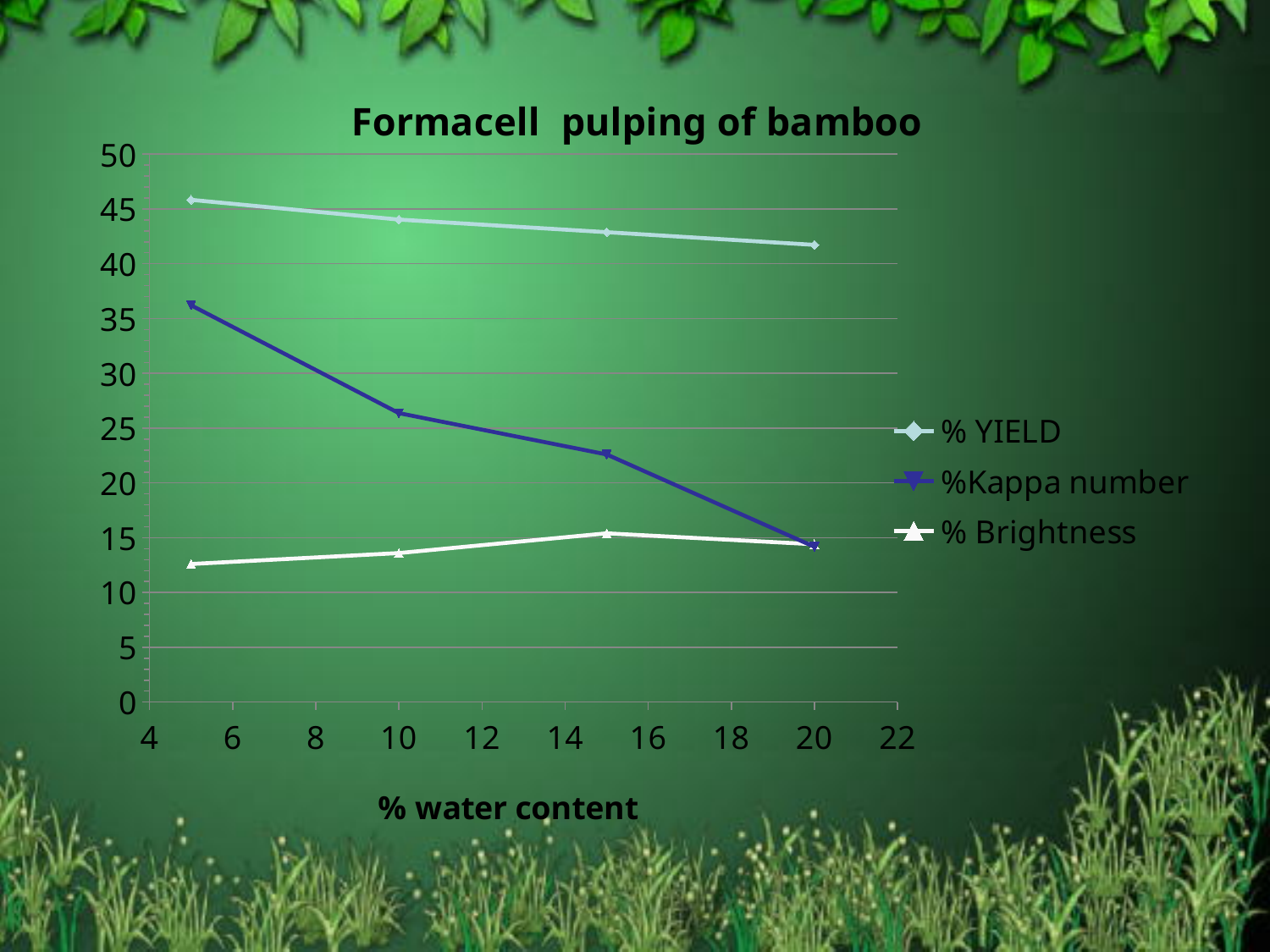
How many series does the legend list? 3 Which series has the lowest value at 5% water content? % Brightness What is the title of the chart? Formacell pulping of bamboo Does the % YIELD series rise or fall as % water content increases? fall Which series has the highest value at 5% water content? % YIELD What is the label of the x axis? % water content Is the %Kappa number value at 5% water content greater or less than 35? greater What kind of chart is shown on the slide? line chart Does the %Kappa number series rise or fall as % water content increases? fall At 10% water content, which is larger: %Kappa number or % Brightness? %Kappa number How many data points are plotted for the % YIELD series? 4 Is the % Brightness value at 5% water content greater or less than 15? less